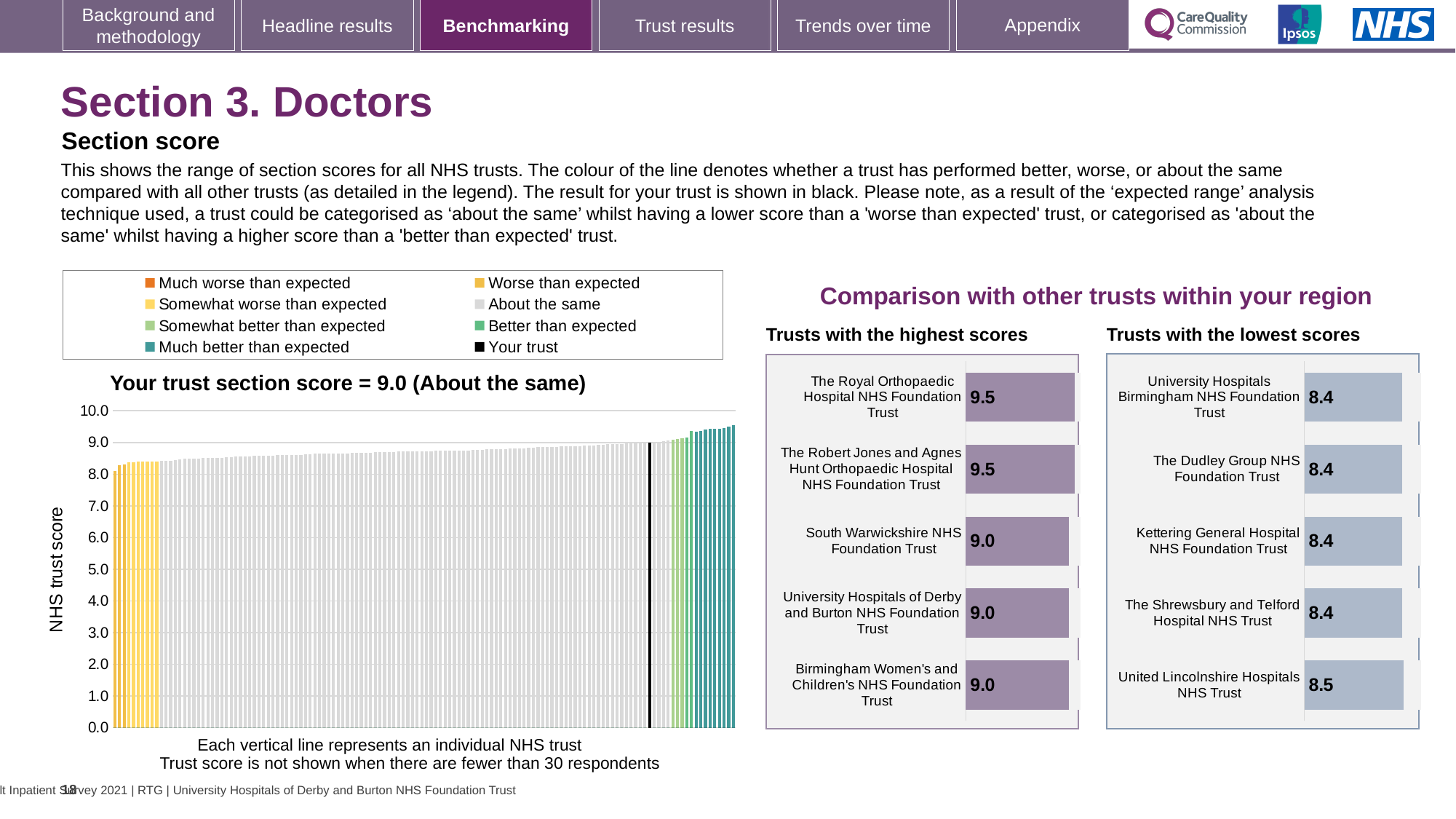
What is the y-axis label of the 'Your trust section score' chart on the left? NHS trust score What type of chart is the 'Your trust section score' chart on the left? Bar chart In the 'Trusts with the lowest scores' chart, what is the score for The Dudley Group NHS Foundation Trust? 8.4 In the 'Trusts with the lowest scores' chart, which is larger: the score for United Lincolnshire Hospitals NHS Trust or the score for Kettering General Hospital NHS Foundation Trust? United Lincolnshire Hospitals NHS Trust How many trusts are listed in the 'Trusts with the highest scores' chart? 5 In the 'Trusts with the highest scores' chart, what is the difference between the score for The Robert Jones and Agnes Hunt Orthopaedic Hospital NHS Foundation Trust and the score for Birmingham Women's and Children's NHS Foundation Trust? 0.5 In the 'Trusts with the lowest scores' chart, which trust has the highest score? United Lincolnshire Hospitals NHS Trust In the 'Trusts with the highest scores' chart, what is the score for South Warwickshire NHS Foundation Trust? 9.0 In the 'Your trust section score' chart on the left, do the bar values rise or fall from left to right along the x axis? Rise In the 'Your trust section score' chart on the left, what is the section score for your trust? 9.0 In the 'Trusts with the lowest scores' chart, what is the score for United Lincolnshire Hospitals NHS Trust? 8.5 In the 'Trusts with the highest scores' chart, what is the score for The Royal Orthopaedic Hospital NHS Foundation Trust? 9.5